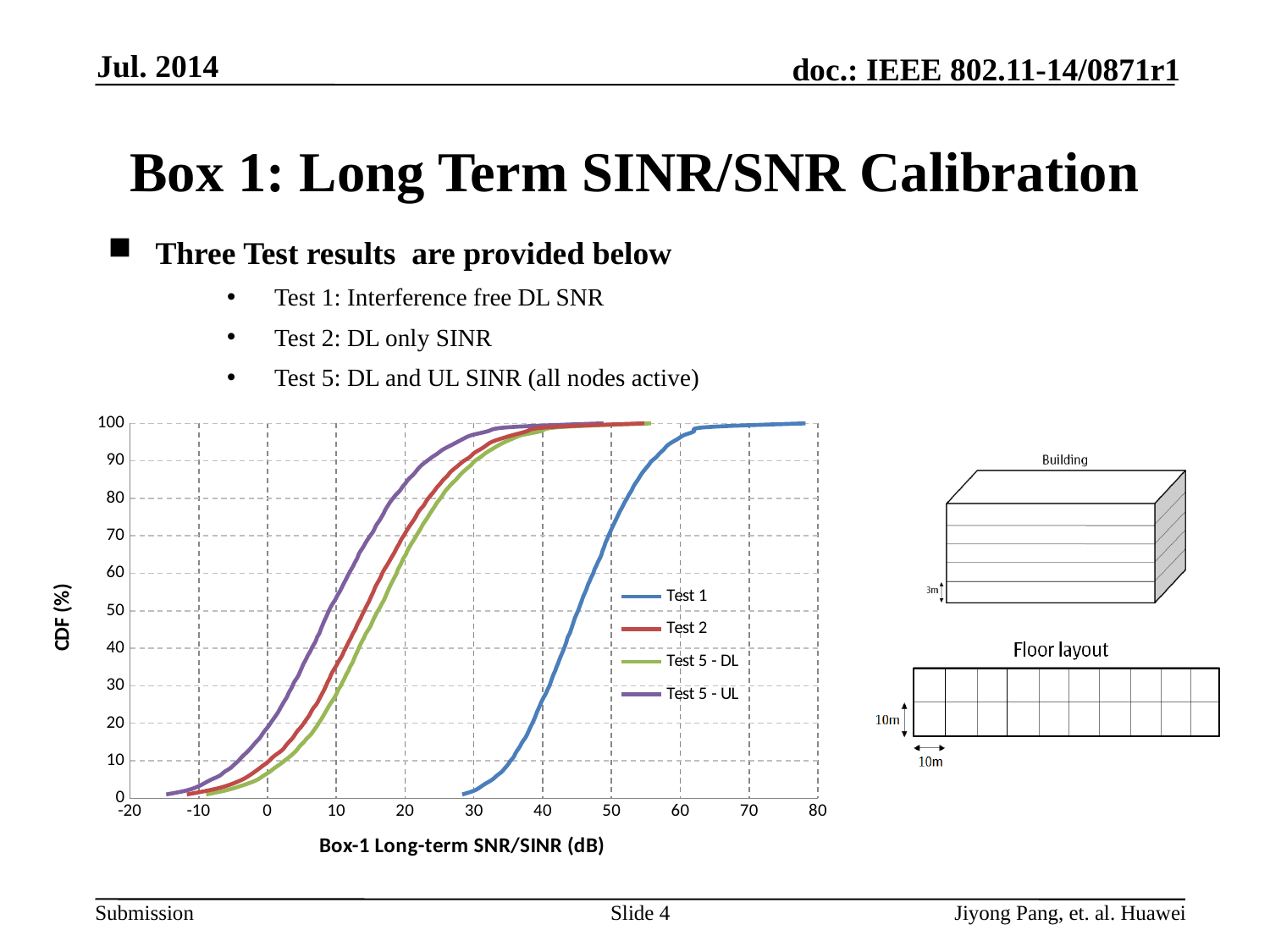
Which colour is used for the Test 1 series in the chart? blue Is the CDF value for Test 1 at 50 dB greater or less than 50? greater Is the CDF value for Test 5 - DL at 10 dB greater or less than 50? less Is the CDF value for Test 2 at 20 dB greater or less than 50? greater How many series does the chart legend list? 4 Which series reaches a CDF of 50% at the lowest SNR/SINR value? Test 5 - UL What kind of chart is shown on the slide? line chart At a CDF of 50%, which series has the higher SNR/SINR value, Test 1 or Test 2? Test 1 Do the CDF curves rise or fall as the SNR/SINR value increases along the x axis? rise What is the x-axis title of the chart? Box-1 Long-term SNR/SINR (dB)